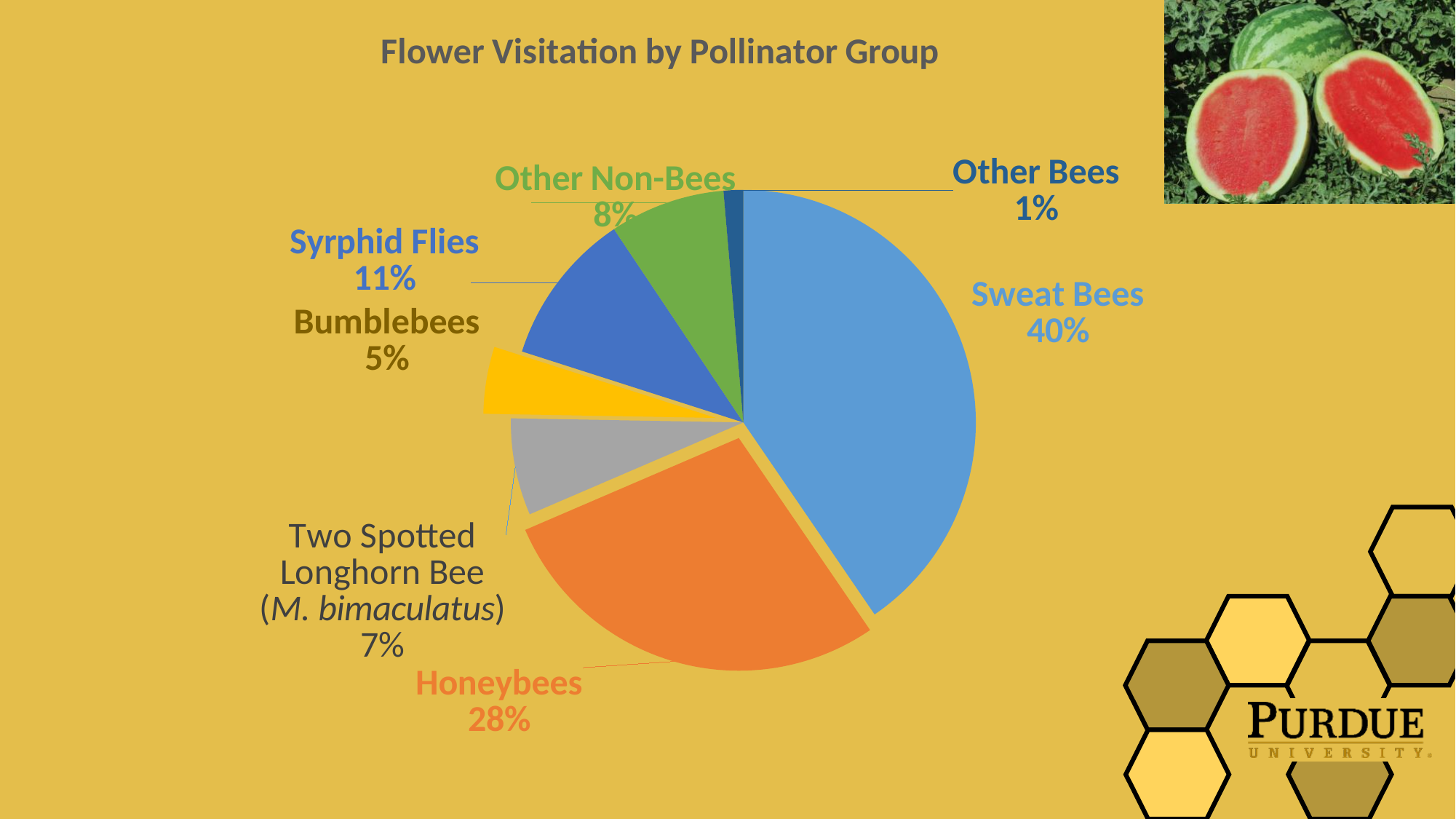
What is the title of the chart? Flower Visitation by Pollinator Group Which pollinator group has the smallest share of flower visitation? Other Bees What share of flower visitation is attributed to Sweat Bees? 40% What colour is the Honeybees slice? orange What percentage of flower visitation is by Honeybees? 28% What percentage is shown for the Two Spotted Longhorn Bee (M. bimaculatus)? 7% What type of chart is shown on the slide? pie chart What is the difference in percentage points between Sweat Bees and Honeybees? 12 Which has a larger share, Other Non-Bees or Bumblebees? Other Non-Bees What is the value shown for Syrphid Flies? 11% Which pollinator group has the largest share of flower visitation? Sweat Bees How many pollinator groups are shown in the pie chart? 7